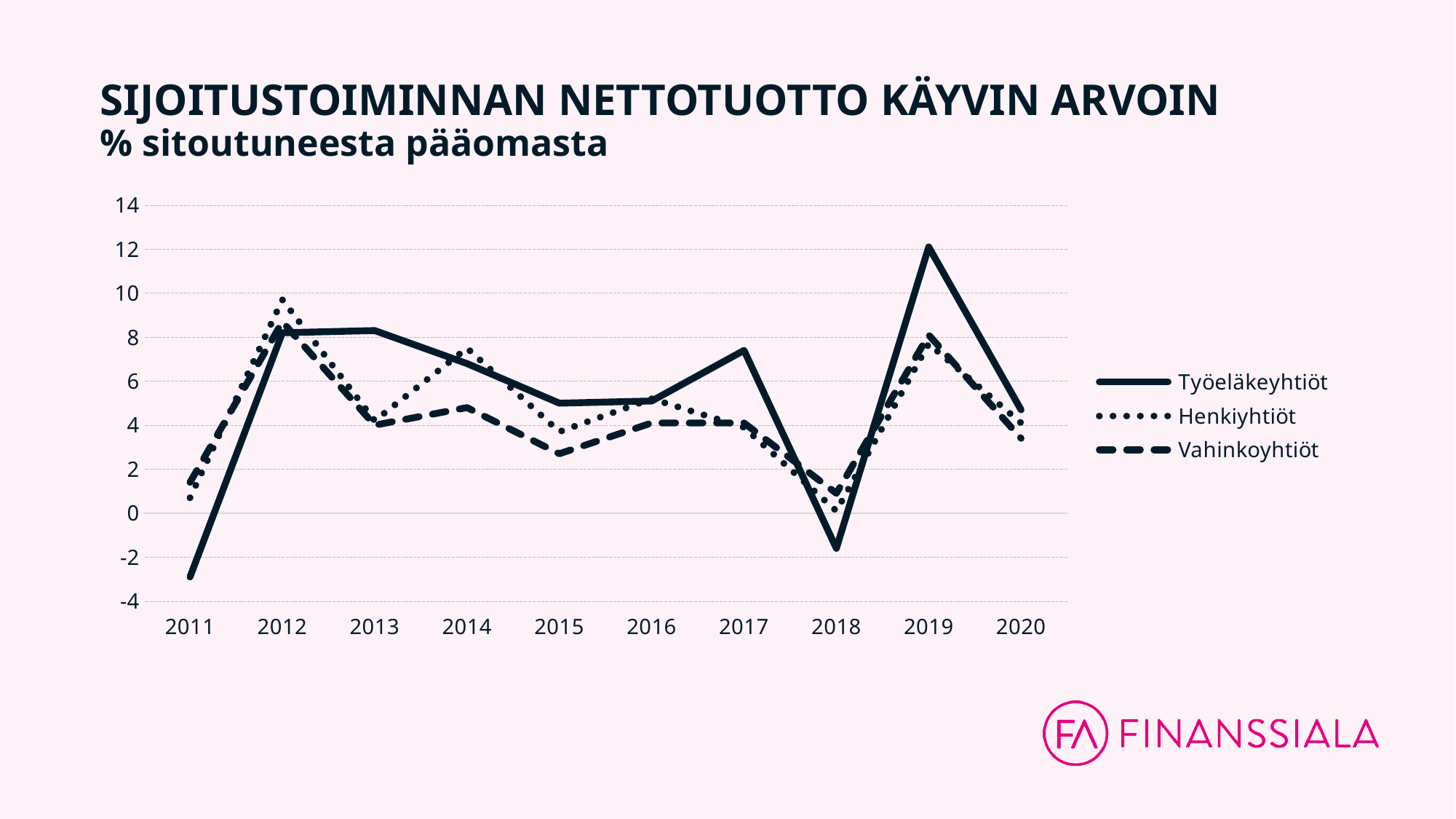
In 2019, which series has the higher value, Työeläkeyhtiöt or Henkiyhtiöt? Työeläkeyhtiöt Is the value for Työeläkeyhtiöt in 2011 greater or less than 0? less Is the value for Vahinkoyhtiöt in 2015 greater or less than 4? less How many series does the legend list? 3 What kind of chart is shown on the slide? line chart Does the Työeläkeyhtiöt line rise or fall from 2019 to 2020? fall Which series is drawn with a dotted line according to the legend? Henkiyhtiöt In 2012, which series has the higher value, Henkiyhtiöt or Työeläkeyhtiöt? Henkiyhtiöt Is the value for Työeläkeyhtiöt in 2019 greater or less than 10? greater How many years are shown on the x axis? 10 In which year does the Työeläkeyhtiöt line reach its highest value? 2019 In which year does the Työeläkeyhtiöt line reach its lowest value? 2011